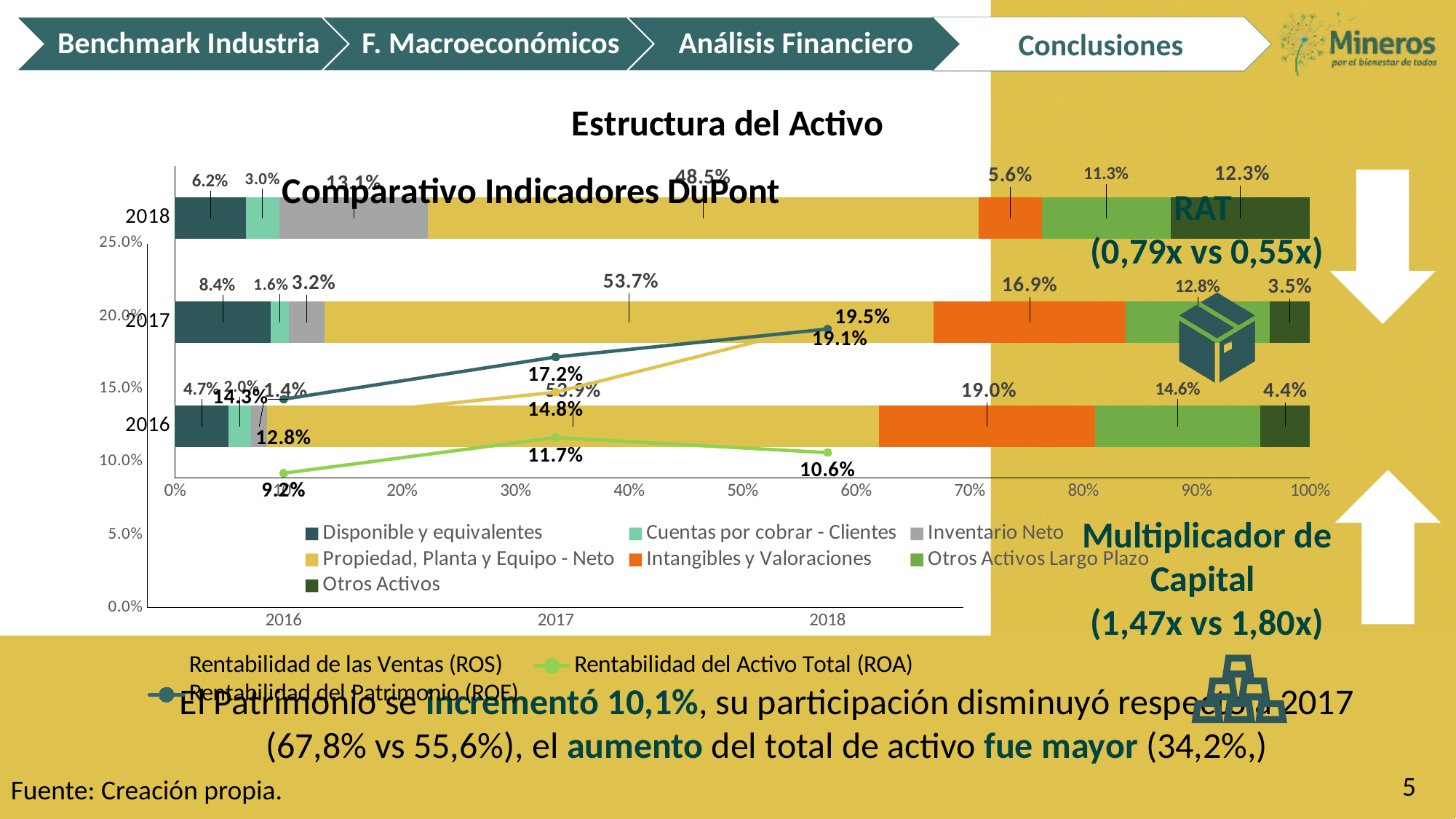
In the 'Estructura del Activo' chart, what share of assets was 'Intangibles y Valoraciones' in 2017? 16.9% In the 'Comparativo Indicadores DuPont' chart, what was the Rentabilidad del Patrimonio (ROE) in 2018? 19.1% In the 'Estructura del Activo' chart, what share of assets was 'Disponible y equivalentes' in 2016? 4.7% What kind of chart is 'Estructura del Activo'? Stacked bar chart In the 'Comparativo Indicadores DuPont' chart, how many series does the legend list? 3 In the 'Estructura del Activo' chart, which year had the highest share of 'Otros Activos'? 2018 In the 'Estructura del Activo' chart, what is the difference between the 'Intangibles y Valoraciones' share in 2016 and in 2018? 13.4% In the 'Comparativo Indicadores DuPont' chart, does the Rentabilidad del Patrimonio (ROE) rise or fall from 2016 to 2018? Rise In the 'Estructura del Activo' chart, what share of assets was 'Propiedad, Planta y Equipo - Neto' in 2018? 48.5% In the 'Estructura del Activo' chart, how many series does the legend list? 7 In the 'Comparativo Indicadores DuPont' chart, which is larger in 2018: Rentabilidad de las Ventas (ROS) or Rentabilidad del Activo Total (ROA)? Rentabilidad de las Ventas (ROS) In the 'Comparativo Indicadores DuPont' chart, what was the Rentabilidad del Activo Total (ROA) in 2017? 11.7%